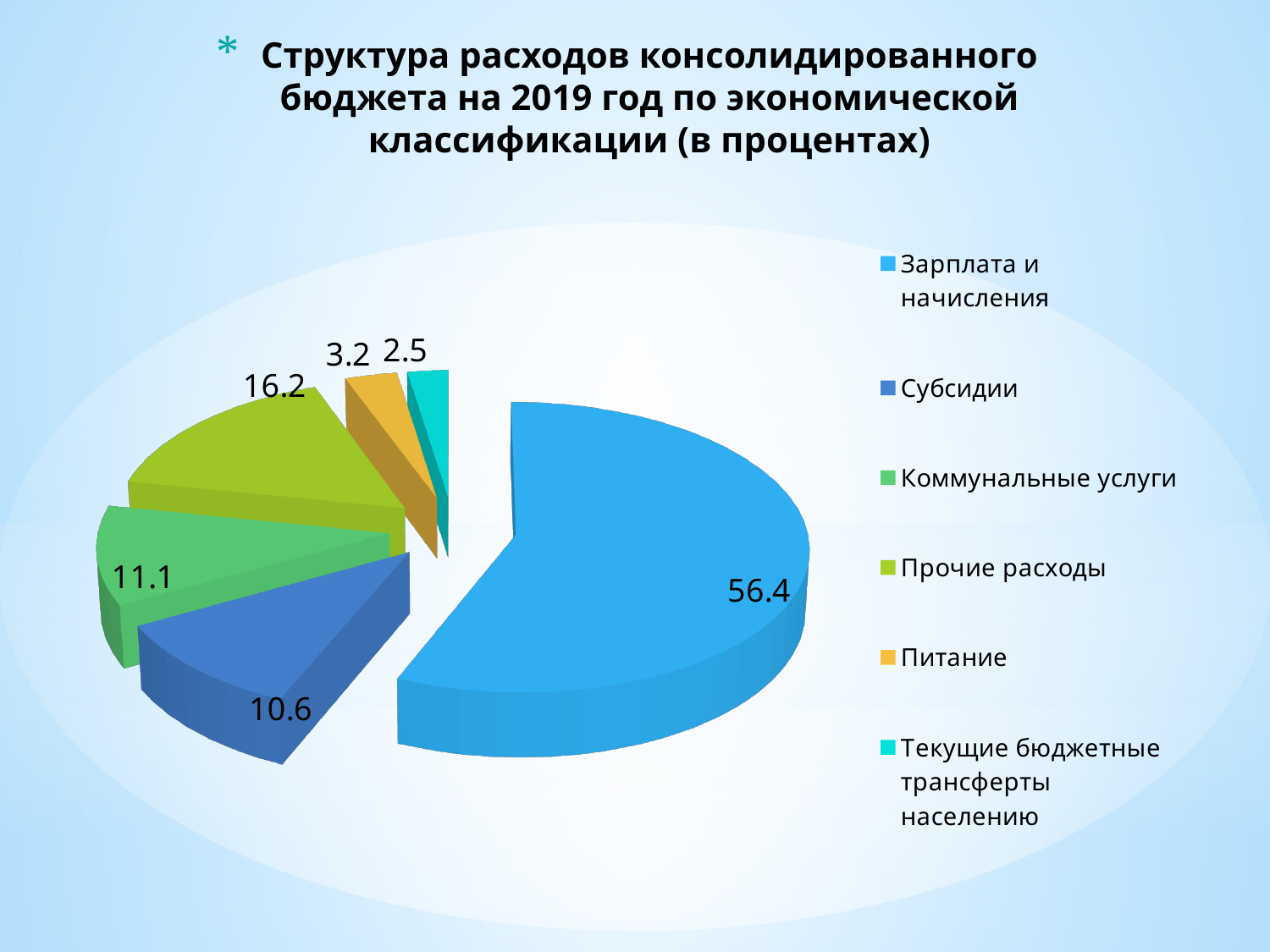
What is the value for Коммунальные услуги? 11.1 What is the value for Субсидии? 10.6 What type of chart is shown on the slide? pie chart Which category has the smallest share of the pie? Текущие бюджетные трансферты населению What is the difference between the values for Прочие расходы and Субсидии? 5.6 Which category has the largest share of the pie? Зарплата и начисления What is the value for Текущие бюджетные трансферты населению? 2.5 What is the value for Прочие расходы? 16.2 What is the value for Питание? 3.2 What is the value for Зарплата и начисления? 56.4 Which is larger, the value for Коммунальные услуги or the value for Субсидии? Коммунальные услуги How many categories does the legend list? 6